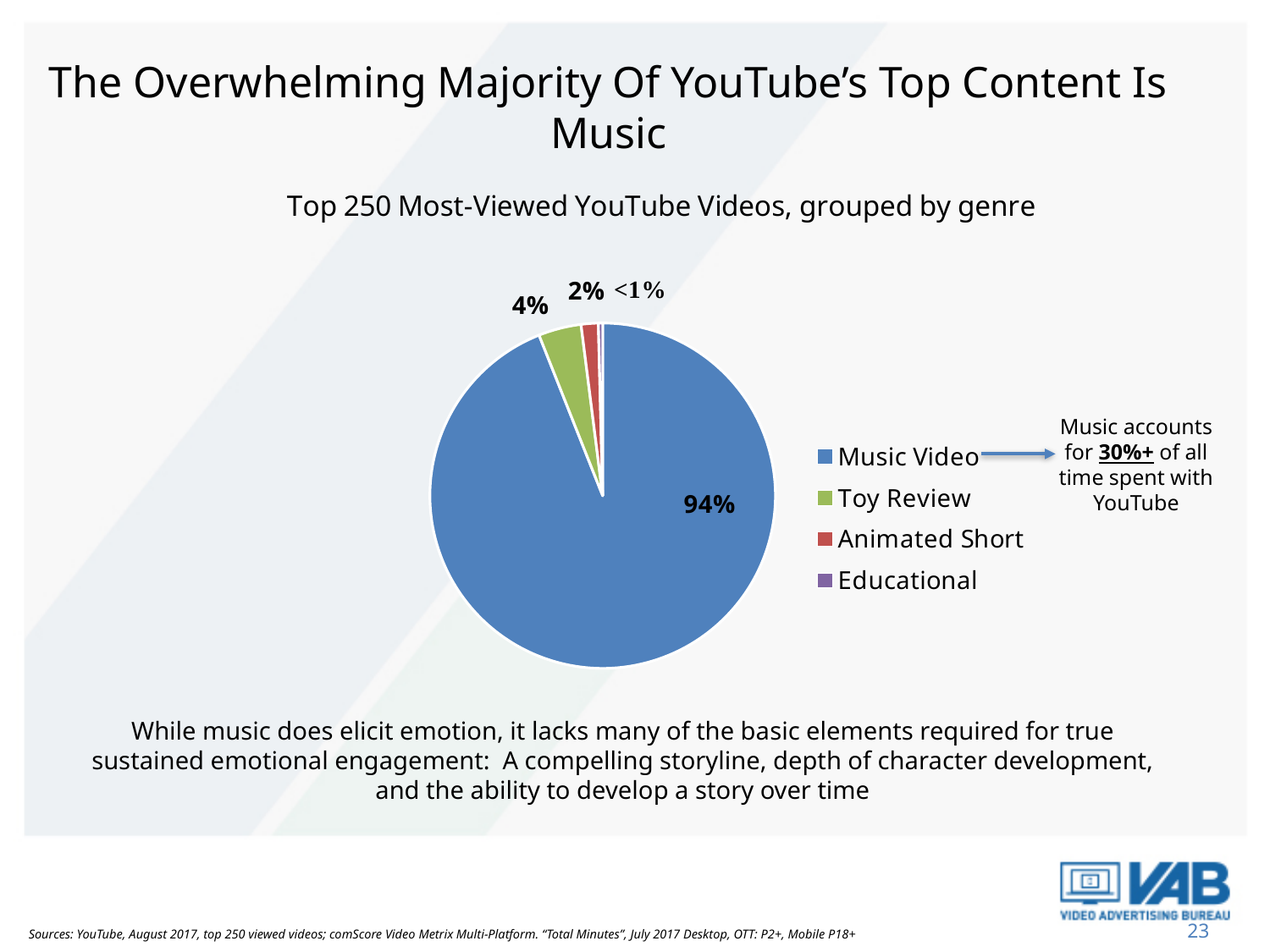
What share of the Top 250 Most-Viewed YouTube Videos is Music Video? 94% What is the difference in percentage points between the Music Video and Toy Review slices? 90 How many genres are shown in the pie chart? 4 What type of chart is shown on the slide? Pie chart Which genre has the largest slice of the pie chart? Music Video What colour is the Toy Review slice in the pie chart? Green Which slice is larger, Toy Review or Animated Short? Toy Review What share of the Top 250 Most-Viewed YouTube Videos is Toy Review? 4% What share of the Top 250 Most-Viewed YouTube Videos is Animated Short? 2% What is the title of the chart? Top 250 Most-Viewed YouTube Videos, grouped by genre What share of the Top 250 Most-Viewed YouTube Videos is Educational? <1% Which genre has the smallest slice of the pie chart? Educational